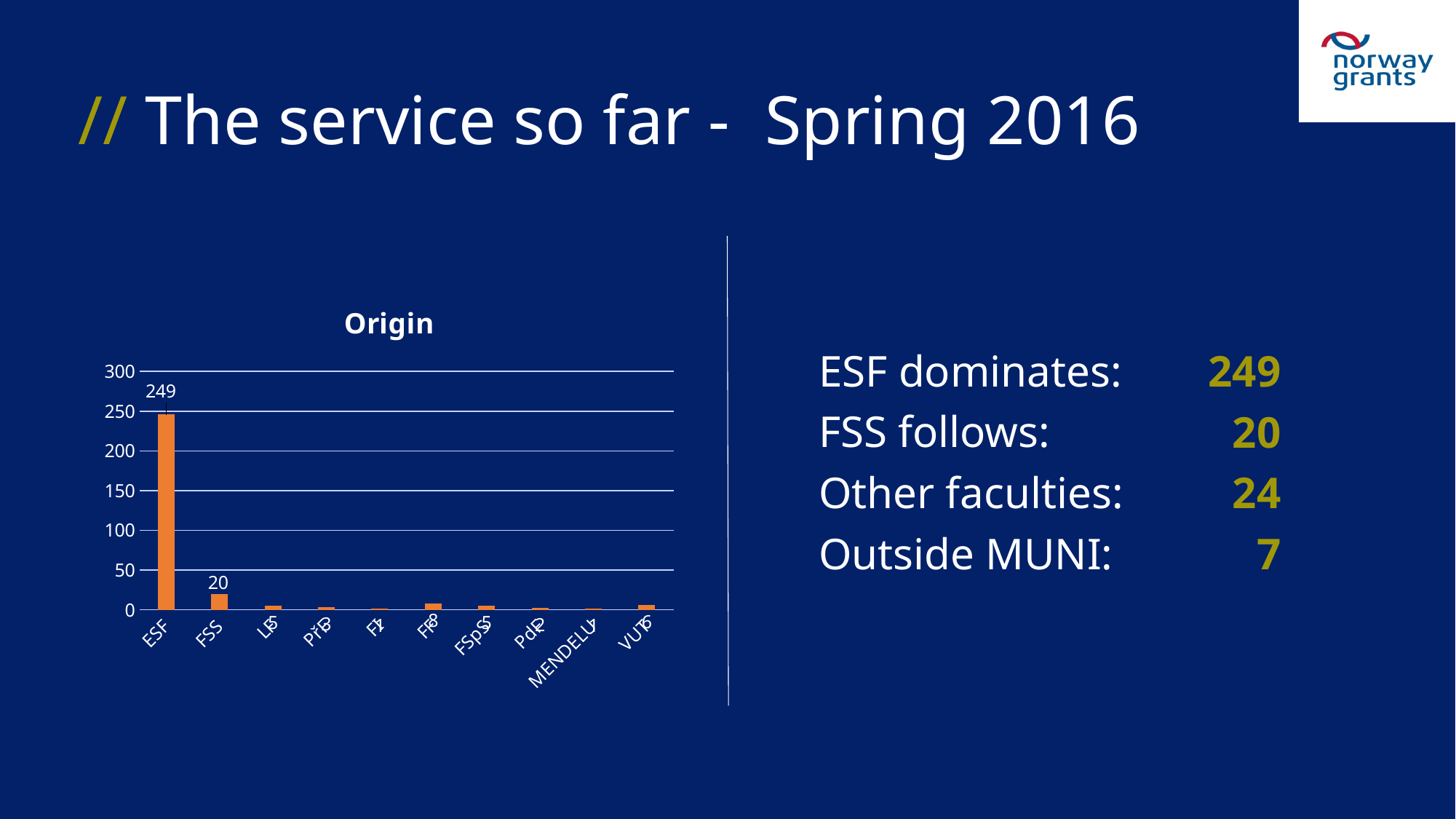
What is the difference between the values for ESF and FSS in the Origin chart? 229 What kind of chart is shown on the slide? bar chart How many categories are shown on the x axis of the Origin chart? 10 What is the value for FSS in the Origin chart? 20 Which category has the highest value in the Origin chart? ESF What is the value for ESF in the Origin chart? 249 Which is larger in the Origin chart, the value for ESF or the value for FSS? ESF Is the value for FF in the Origin chart greater or less than 50? less What is the title of the chart on the slide? Origin Is the value for FSS in the Origin chart greater or less than 50? less Is the value for ESF in the Origin chart greater or less than 200? greater Which is larger in the Origin chart, the value for FSS or the value for FF? FSS